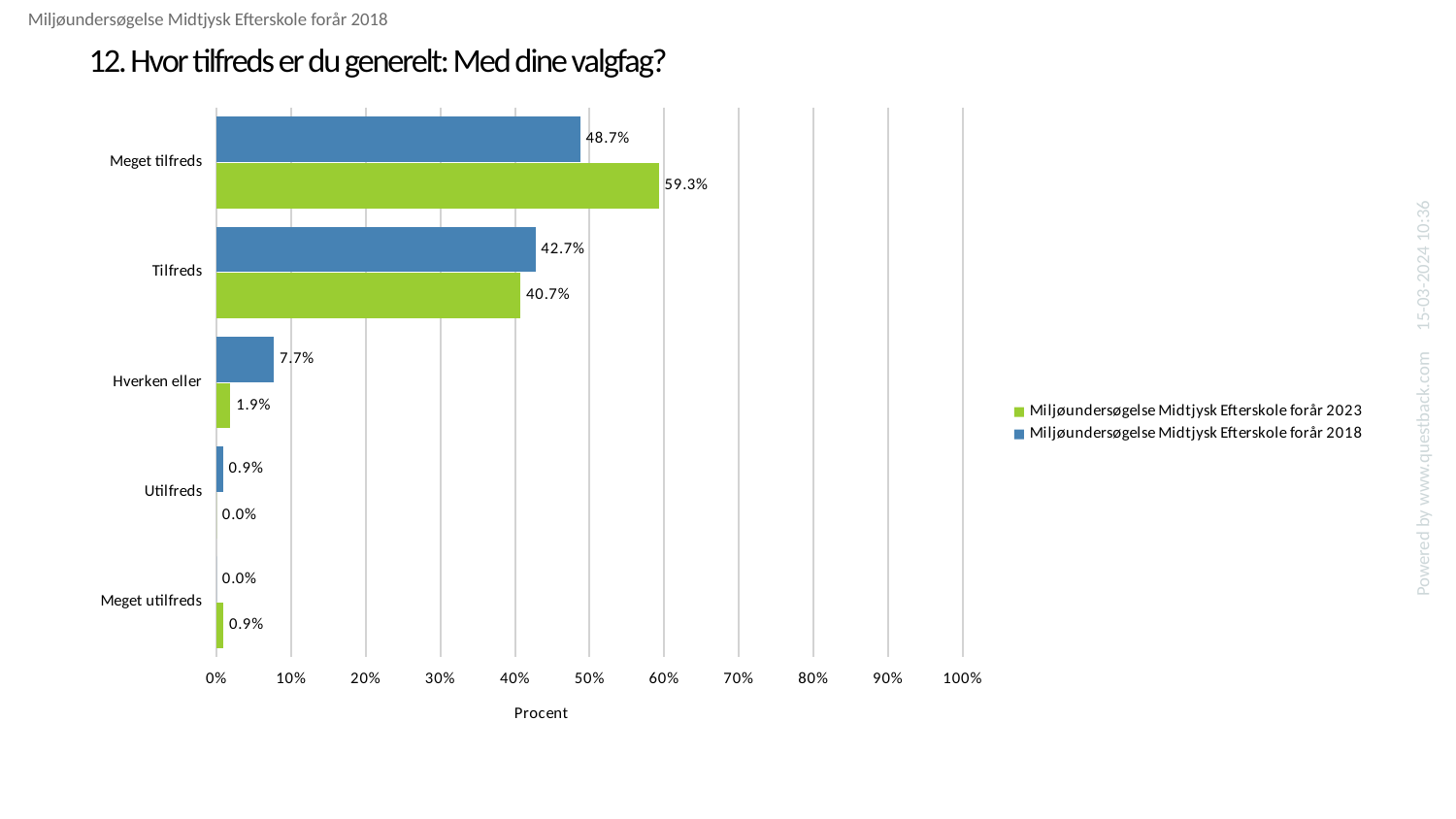
What is the value for "Hverken eller" in the Miljøundersøgelse Midtjysk Efterskole forår 2023 series? 1.9% For "Hverken eller", which series has the larger value: 2018 or 2023? 2018 Which category has the lowest value in the Miljøundersøgelse Midtjysk Efterskole forår 2018 series? Meget utilfreds Which category has the highest value in the Miljøundersøgelse Midtjysk Efterskole forår 2018 series? Meget tilfreds How many series does the legend list? 2 What is the difference between the 2023 and 2018 values for "Meget tilfreds"? 10.6% What is the value for "Meget tilfreds" in the Miljøundersøgelse Midtjysk Efterskole forår 2023 series? 59.3% What is the value for "Tilfreds" in the Miljøundersøgelse Midtjysk Efterskole forår 2018 series? 42.7% What is the label of the horizontal axis? Procent Is the value for "Tilfreds" in the 2023 series greater or less than 50%? less How many categories are shown on the chart? 5 What kind of chart is shown on the slide? Bar chart